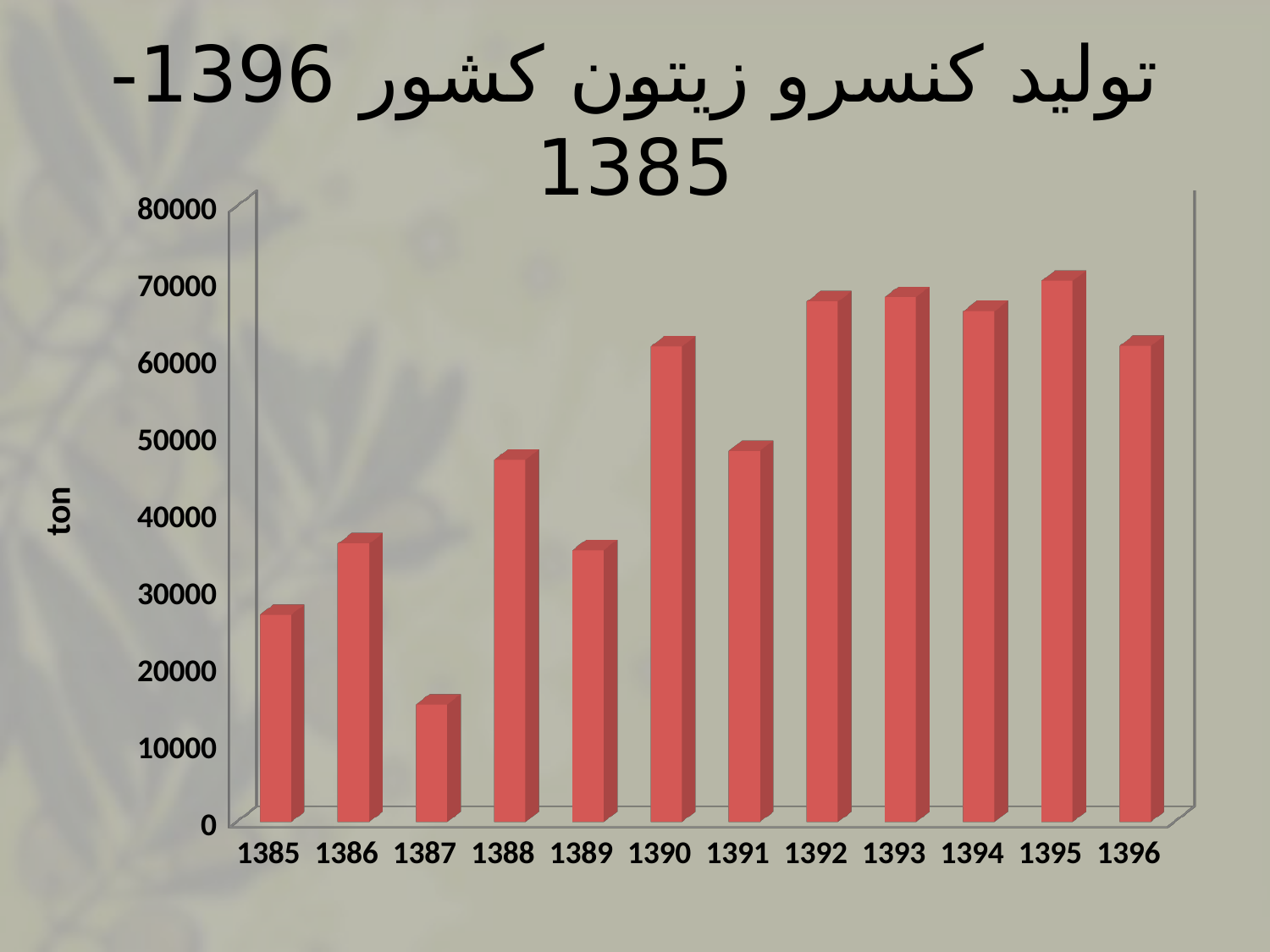
Which is larger, the value for 1390 or the value for 1391? 1390 Is the value for 1390 greater or less than 60000? greater How many years (bars) are plotted on the chart? 12 What kind of chart is shown on the slide? bar chart Is the value for 1387 greater or less than 20000? less Does the value rise or fall from 1395 to 1396? fall Which year has the highest value on the chart? 1395 What unit is shown on the vertical axis label? ton Is the value for 1388 greater or less than 50000? less Which is larger, the value for 1388 or the value for 1389? 1388 Which year has the lowest value on the chart? 1387